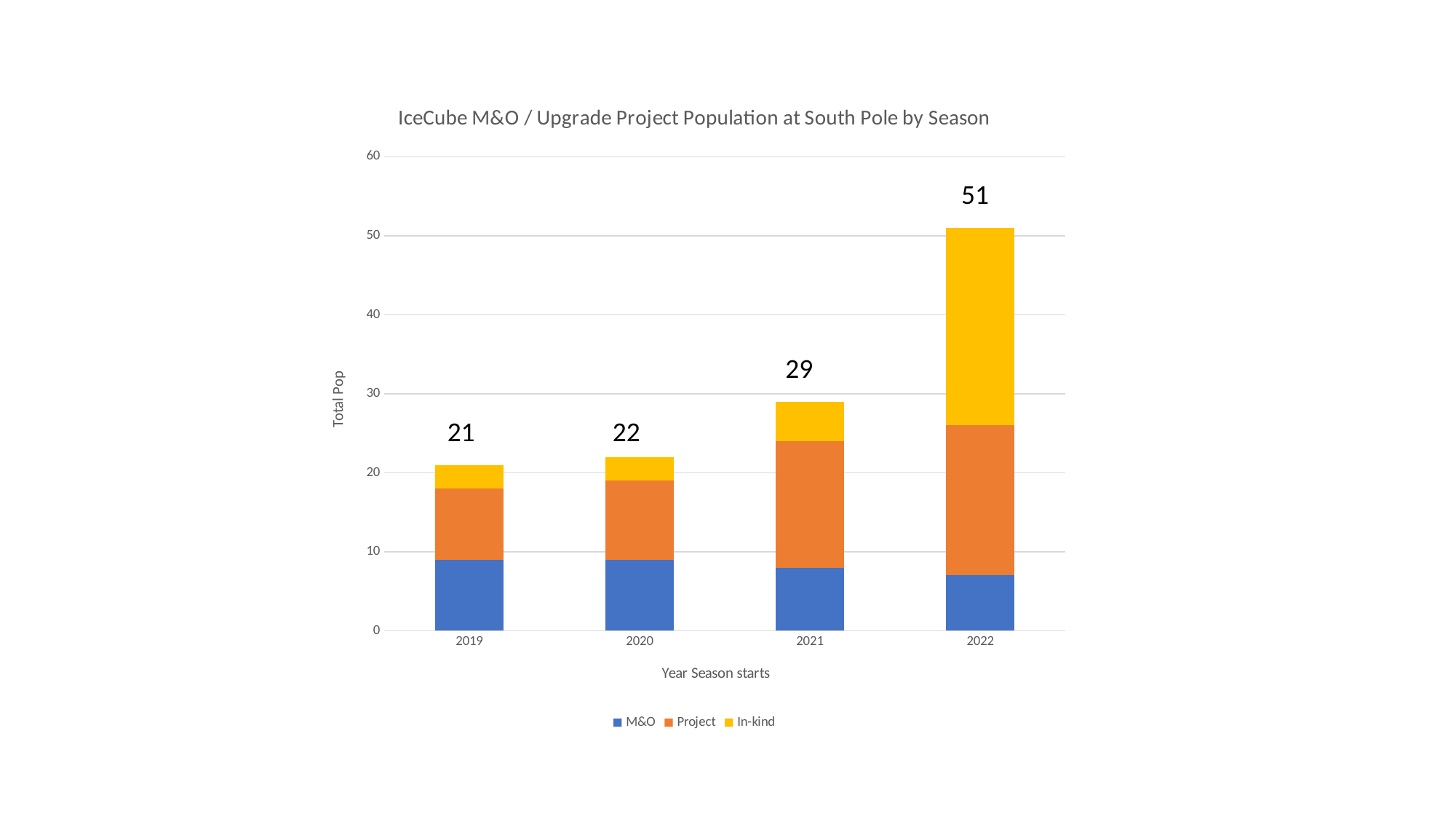
Do the total populations rise or fall from 2019 to 2022? rise Is the M&O value for 2022 greater or less than 10? less How many series does the legend list? 3 Which season has a larger total population, 2020 or 2021? 2021 What is the total population shown for the 2022 season? 51 Is the In-kind value for 2022 greater or less than 20? greater Which season has the highest total population? 2022 What is the difference between the total population in 2022 and in 2021? 22 Which season has the lowest total population? 2019 What is the total population shown for the 2021 season? 29 How many seasons are shown on the x axis? 4 What is the total population shown for the 2019 season? 21